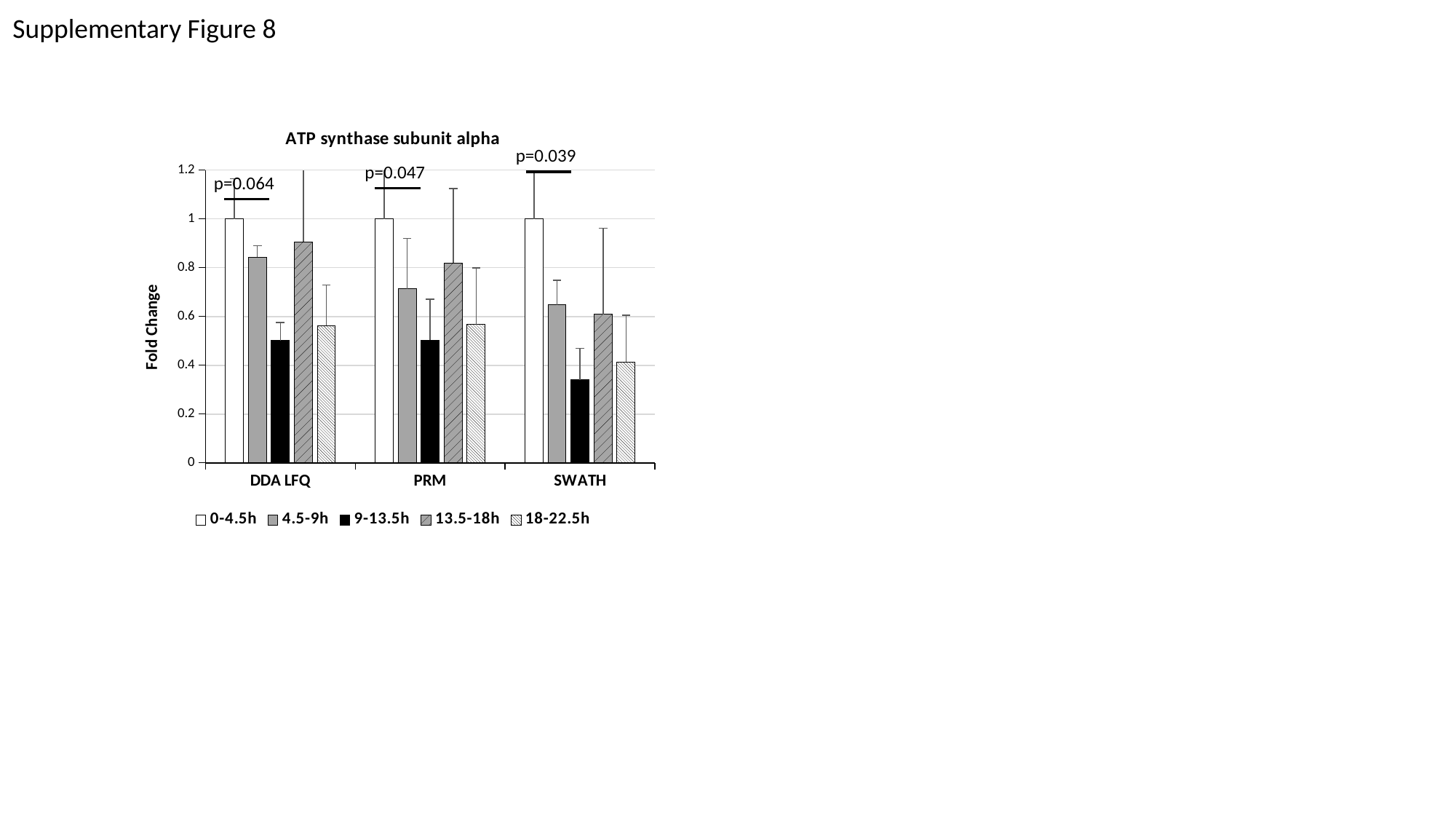
How many categories are shown on the x axis? 3 Which is larger: the 9-13.5h value for PRM or the 9-13.5h value for SWATH? PRM Is the value for the 4.5-9h series in DDA LFQ greater or less than 0.8? greater Is the value for the 9-13.5h series in SWATH greater or less than 0.4? less What kind of chart is shown on the slide? bar chart Is the value for the 4.5-9h series in PRM greater or less than 0.6? greater What is the fold change for the 0-4.5h series in the PRM category? 1 Which series has the lowest fold change in the SWATH category? 9-13.5h What p-value is annotated above the SWATH group? p=0.039 How many series does the legend list? 5 What is the title of the chart? ATP synthase subunit alpha